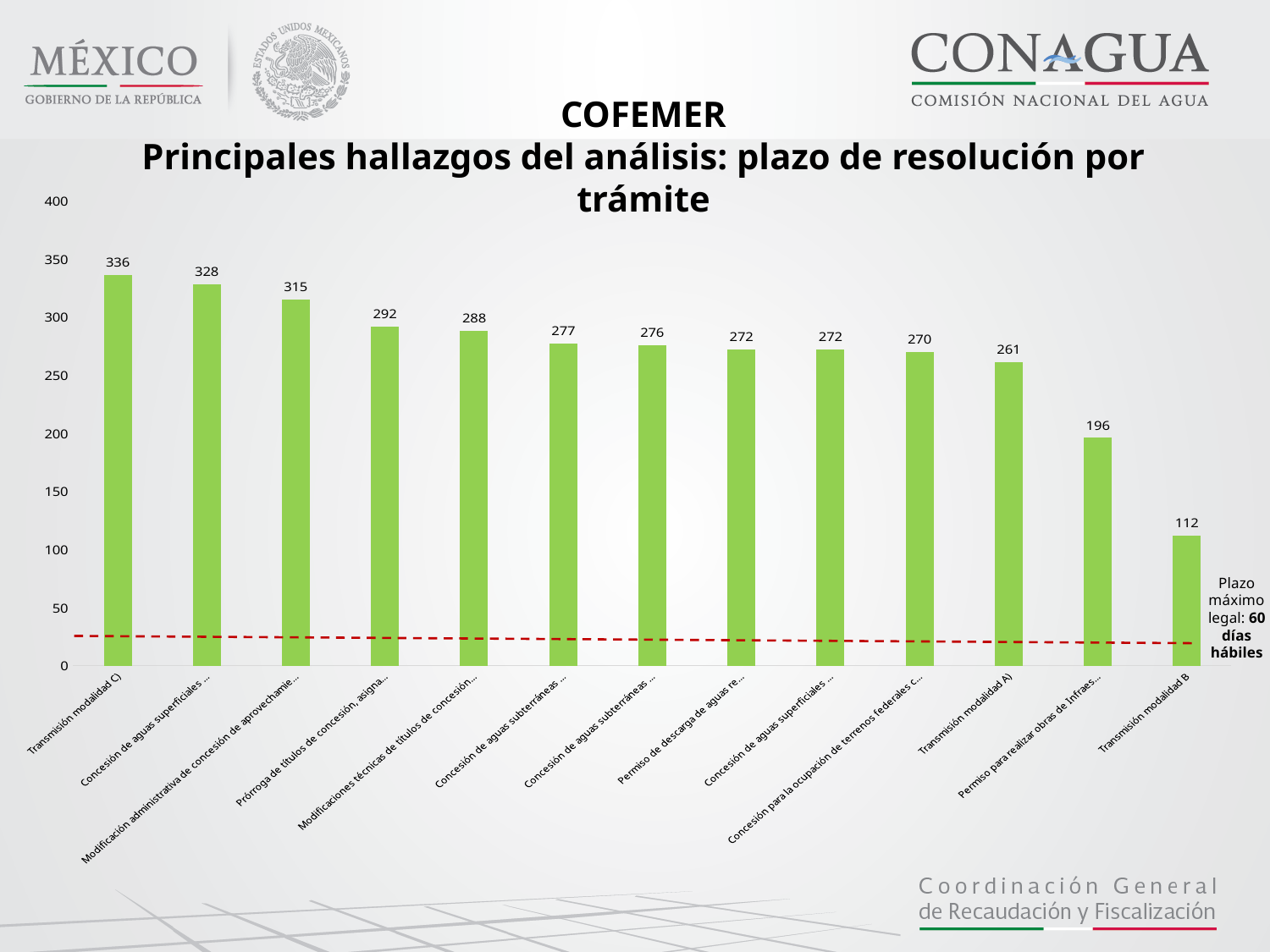
What is the difference between the values for Transmisión modalidad C) and Transmisión modalidad B? 224 What is the difference between the values for Transmisión modalidad A) and Transmisión modalidad B? 149 Which is larger, the value for Transmisión modalidad A) or the value for Transmisión modalidad B? Transmisión modalidad A) Is the value for Transmisión modalidad B greater or less than 150? less How many bars are shown in the chart? 13 What is the value for Transmisión modalidad B? 112 What is the value for Transmisión modalidad C)? 336 What does the red dashed line in the chart represent? Plazo máximo legal: 60 días hábiles What kind of chart is shown on the slide? bar chart Which category has the highest value? Transmisión modalidad C) What is the value for Transmisión modalidad A)? 261 Which category has the lowest value? Transmisión modalidad B